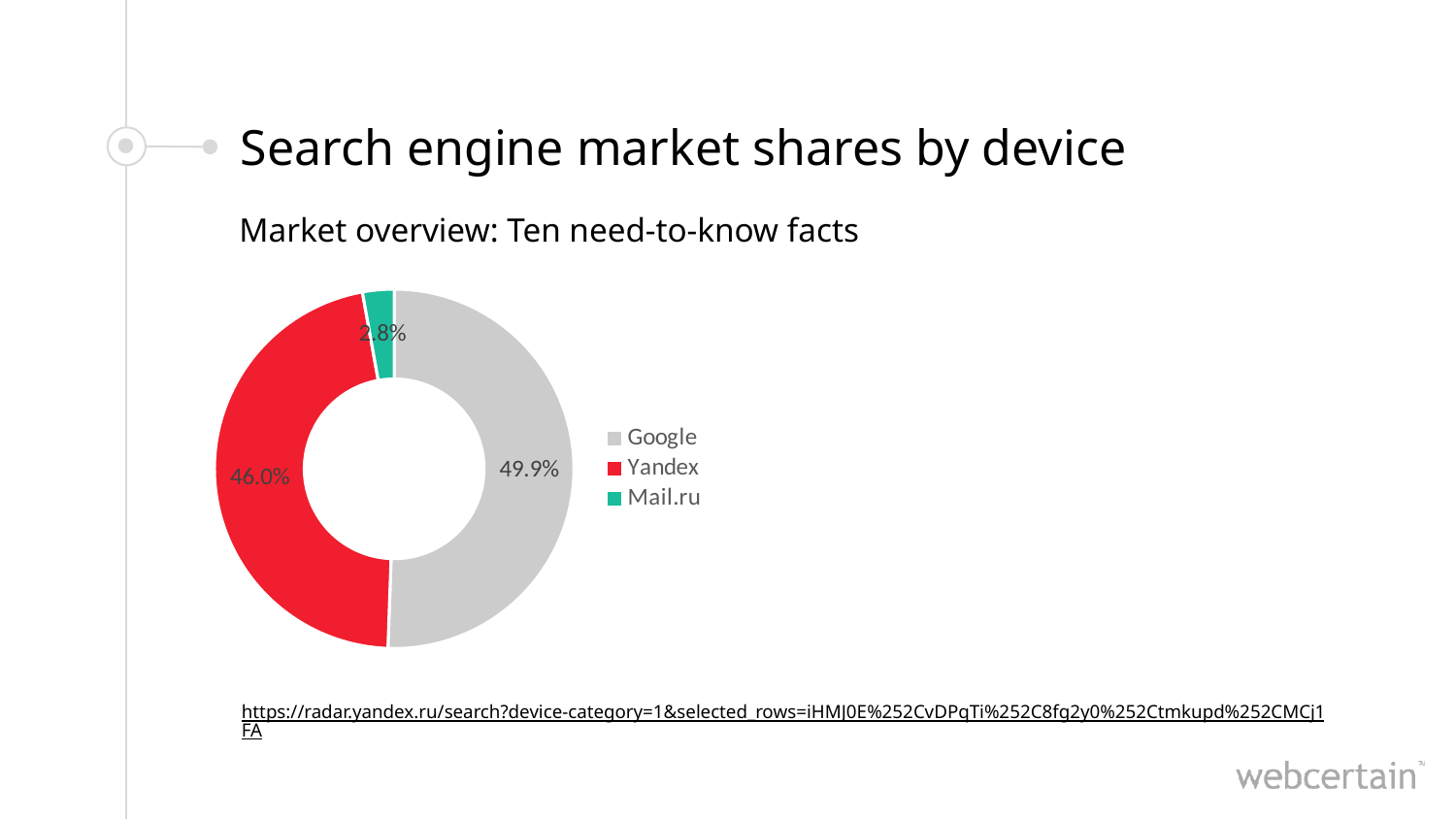
What is the title of the slide containing the chart? Search engine market shares by device What share of the chart does Mail.ru have? 2.8% What colour represents Yandex in the chart? Red What kind of chart is shown on the slide? Doughnut (pie) chart How many search engines are shown in the chart? 3 What is the difference in percentage points between Yandex's and Mail.ru's shares? 43.2 Which search engine has the largest share in the chart? Google What is the difference in percentage points between Google's and Yandex's shares? 3.9 What share of the chart does Google have? 49.9% Which search engine has the smallest share in the chart? Mail.ru Which has a larger share, Yandex or Mail.ru? Yandex What share of the chart does Yandex have? 46.0%